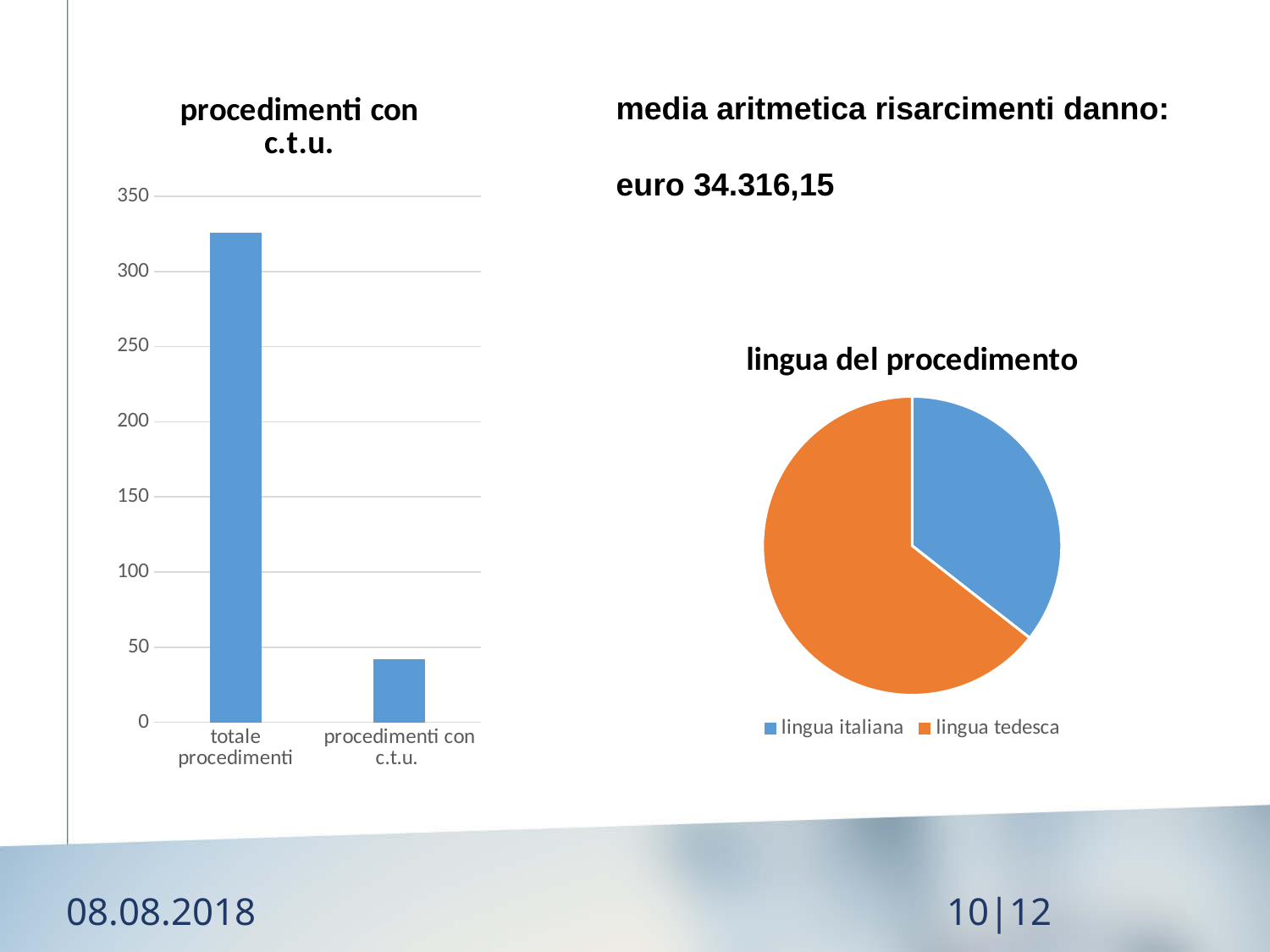
In the chart titled "procedimenti con c.t.u.", which category has the highest value? totale procedimenti In the chart titled "lingua del procedimento", how many entries does the legend list? 2 In the chart titled "procedimenti con c.t.u.", which category has the lowest value? procedimenti con c.t.u. In the chart titled "procedimenti con c.t.u.", is the value for totale procedimenti greater or less than 300? greater What kind of chart is the chart titled "lingua del procedimento"? pie chart In the chart titled "lingua del procedimento", what colour is the slice for lingua italiana? blue In the chart titled "procedimenti con c.t.u.", which is larger: totale procedimenti or procedimenti con c.t.u.? totale procedimenti What kind of chart is the chart titled "procedimenti con c.t.u."? bar chart In the chart titled "procedimenti con c.t.u.", how many bars are plotted? 2 In the chart titled "lingua del procedimento", which slice is the largest? lingua tedesca In the chart titled "procedimenti con c.t.u.", is the value for procedimenti con c.t.u. greater or less than 50? less In the chart titled "lingua del procedimento", how many slices does the pie have? 2